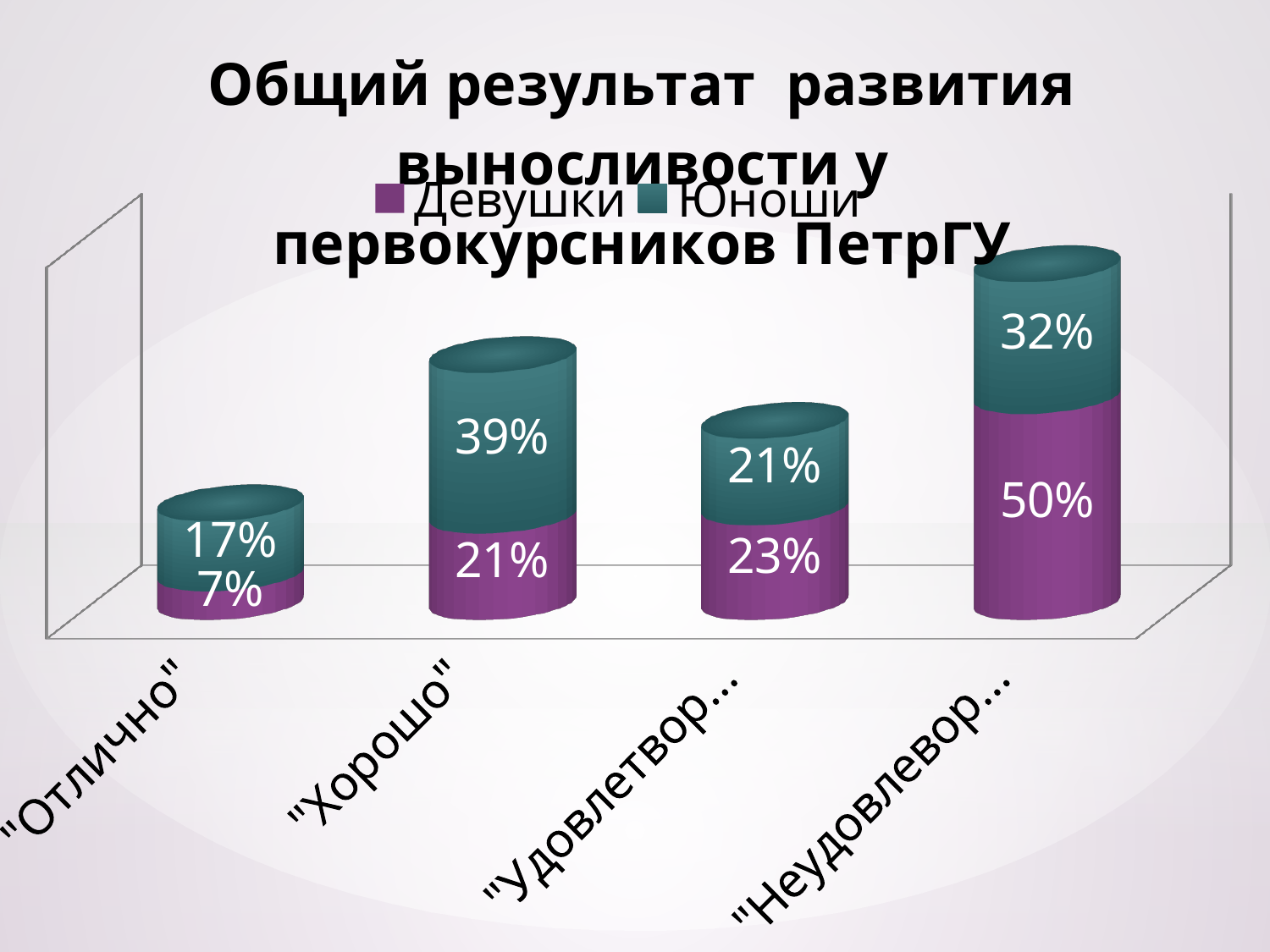
What kind of chart is shown on the slide? Stacked bar chart What is the value for Девушки in the "Неудовлевор..." category? 50% What is the value for Девушки in the "Отлично" category? 7% How many categories are shown on the x axis? 4 In the "Удовлетвор..." category, which series has the larger value, Девушки or Юноши? Девушки Which category has the lowest value for Юноши? "Отлично" What is the value for Юноши in the "Хорошо" category? 39% What is the total of the stacked bar for "Отлично"? 24% In the "Хорошо" category, how much larger is the Юноши value than the Девушки value? 18% Which category has the highest value for Девушки? "Неудовлевор..." What is the value for Юноши in the "Удовлетвор..." category? 21% How many series does the legend list? 2